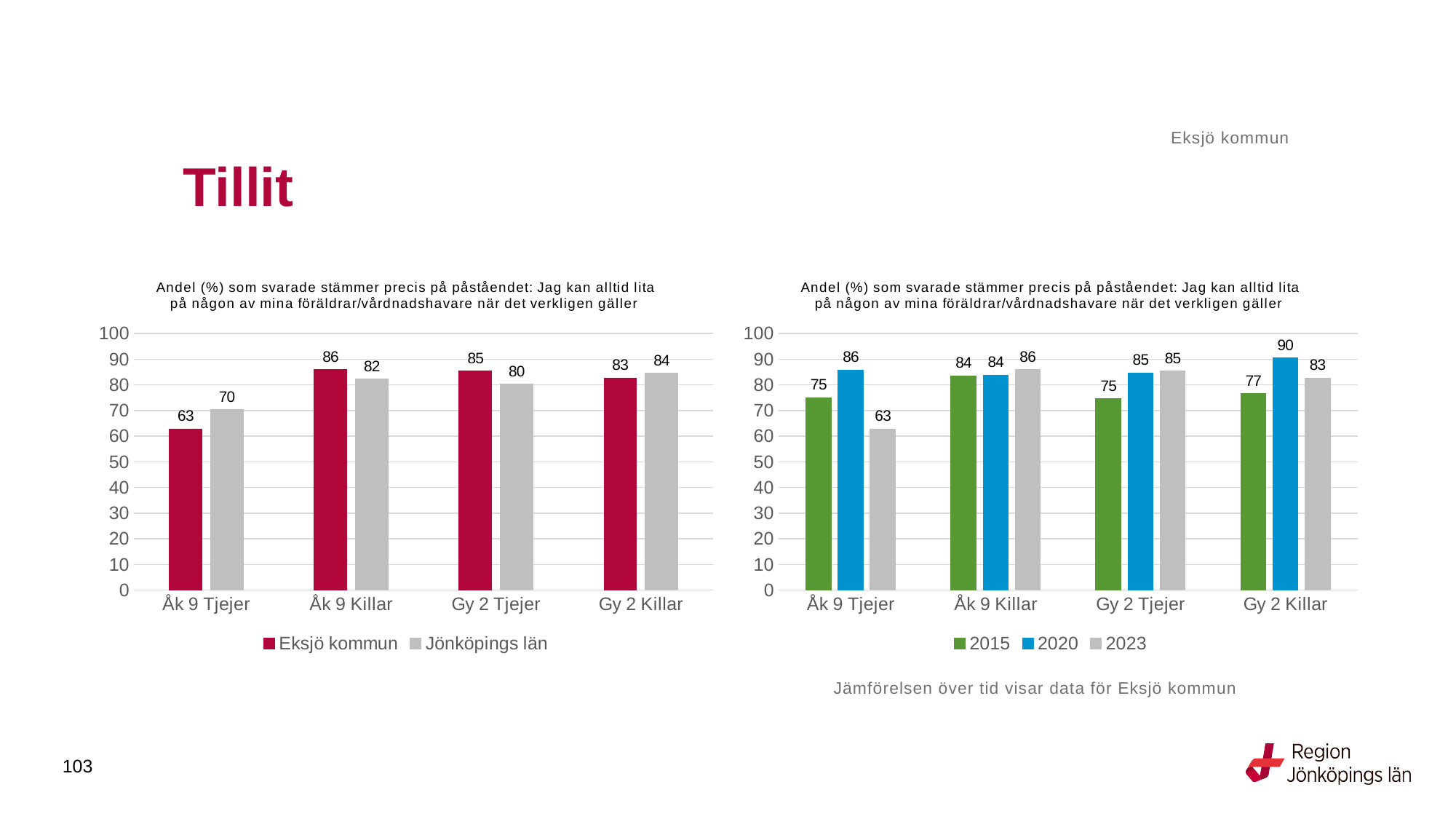
In the left chart, what is the difference between Eksjö kommun and Jönköpings län for Åk 9 Tjejer? 7 What kind of chart is the left chart? Bar chart In the left chart, which category has the highest value for Eksjö kommun? Åk 9 Killar In the right chart, how many series does the legend list? 3 In the left chart, what is the value for Eksjö kommun for Åk 9 Tjejer? 63 In the left chart, which is larger for Gy 2 Tjejer: Eksjö kommun or Jönköpings län? Eksjö kommun In the left chart, what is the value for Jönköpings län for Gy 2 Killar? 84 In the right chart, what is the value for 2020 for Gy 2 Killar? 90 In the right chart, what is the value for 2023 for Åk 9 Tjejer? 63 In the right chart, what is the difference between the 2020 and 2023 values for Åk 9 Tjejer? 23 In the right chart, how many categories are shown on the x axis? 4 In the left chart, which category has the lowest value for Jönköpings län? Åk 9 Tjejer